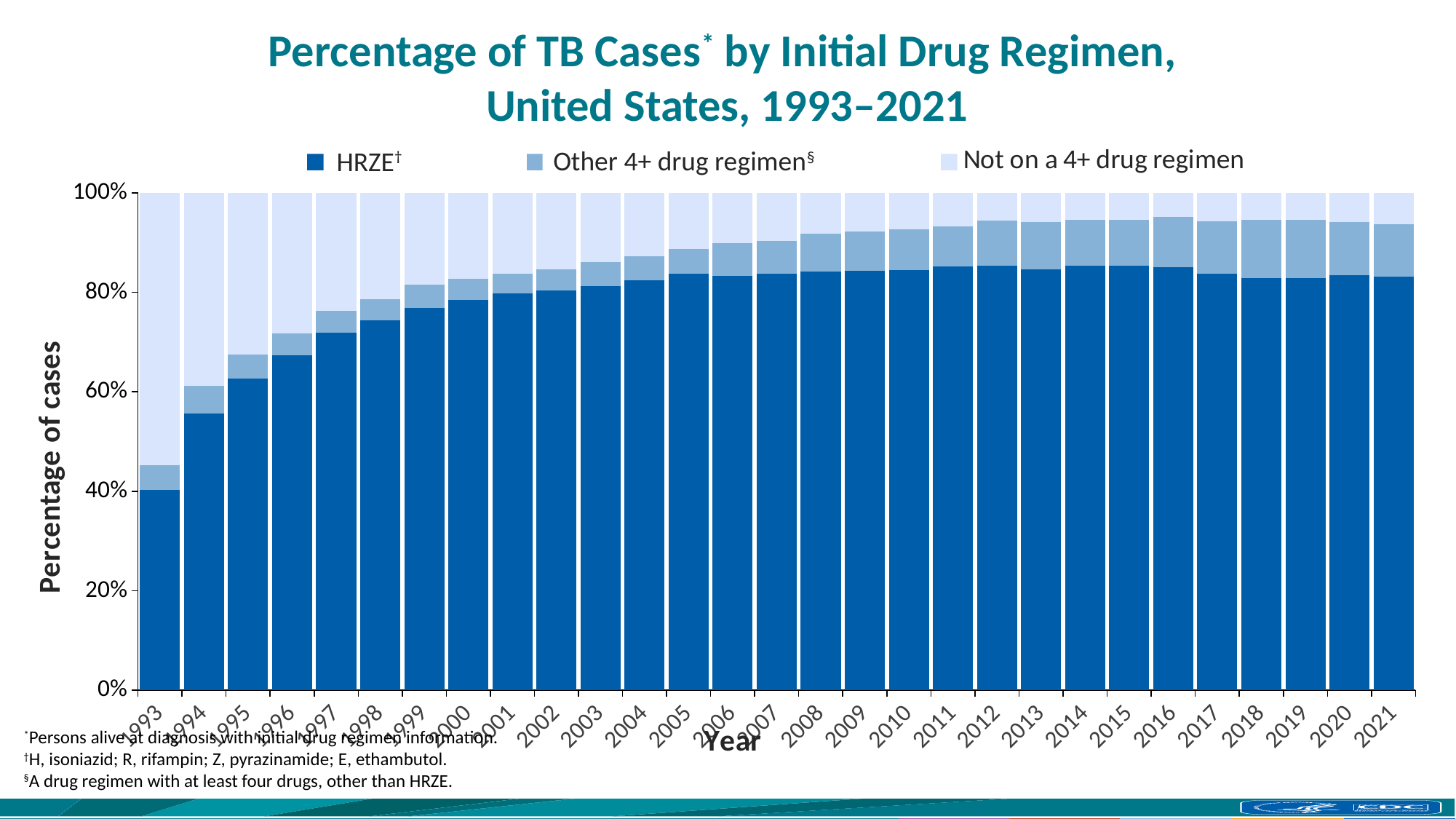
Is the HRZE value for 1996 greater or less than 60%? greater Is the HRZE value for 2021 greater or less than 80%? greater What kind of chart is shown on the slide? Stacked bar chart Does the HRZE percentage generally rise or fall from 1993 to 2021? Rise Which year has the larger HRZE percentage, 1993 or 2021? 2021 What is the total of the stacked bar for 2010? 100% What is the label of the lightest-coloured series in the legend? Not on a 4+ drug regimen How many years (bars) are plotted on the x axis? 29 How many series does the legend list? 3 Is the HRZE value for 1994 greater or less than 60%? less Which year has the lowest HRZE percentage? 1993